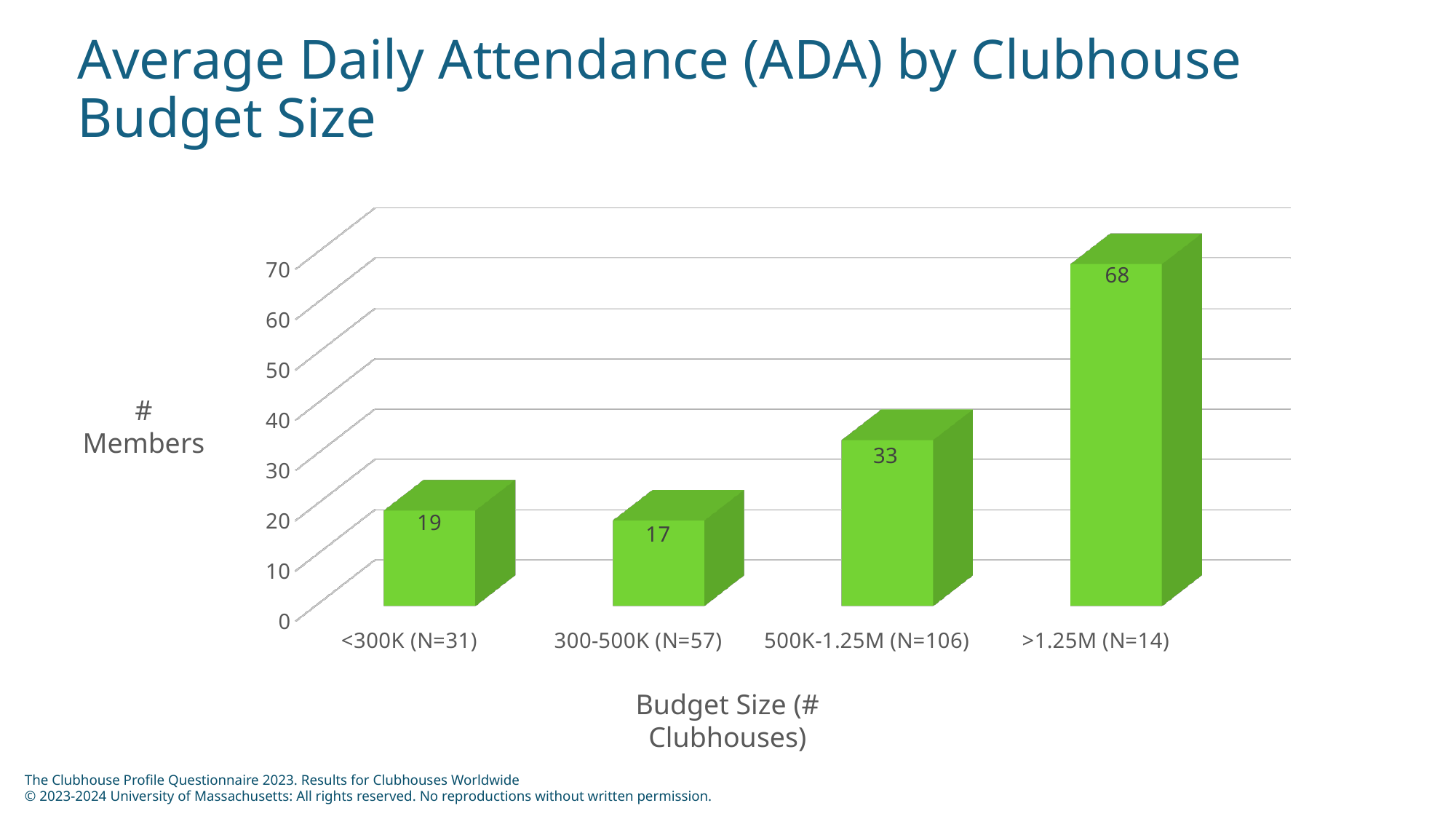
What is the difference in average daily attendance between the >1.25M (N=14) and 500K-1.25M (N=106) categories? 35 Is the value for >1.25M (N=14) greater or less than 60? greater Which budget size category has the lowest average daily attendance? 300-500K (N=57) What kind of chart is shown on the slide? Bar chart How many budget size categories are shown on the chart? 4 Which has a higher average daily attendance: <300K (N=31) or 500K-1.25M (N=106)? 500K-1.25M (N=106) What is the average daily attendance for clubhouses with a budget of 300-500K (N=57)? 17 What is the label of the vertical axis on the chart? # Members What is the average daily attendance for clubhouses with a budget of 500K-1.25M (N=106)? 33 What is the average daily attendance for clubhouses with a budget of >1.25M (N=14)? 68 What is the average daily attendance for clubhouses with a budget of <300K (N=31)? 19 Which budget size category has the highest average daily attendance? >1.25M (N=14)